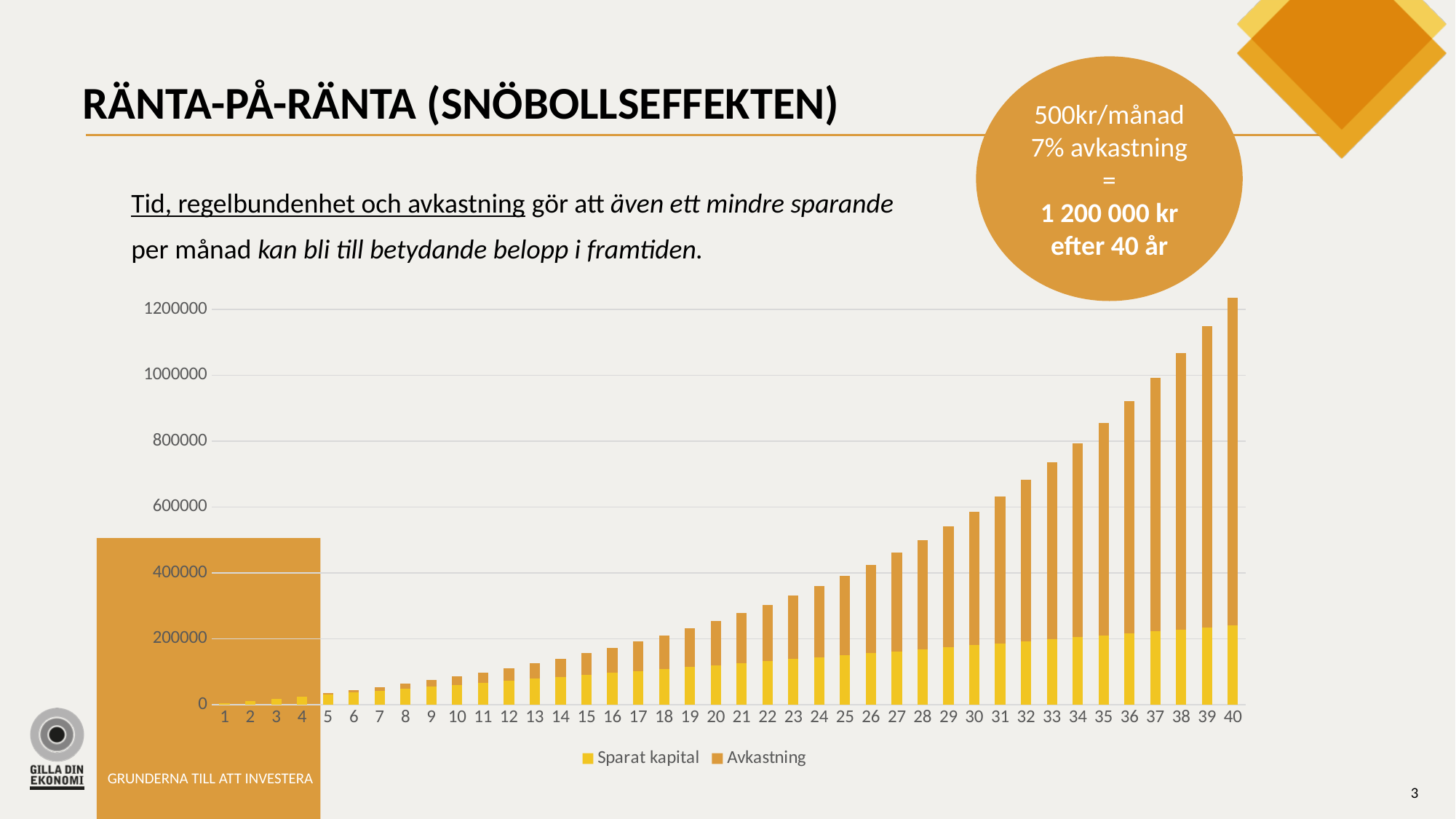
Which has the larger total bar, year 40 or year 20? Year 40 How many series does the chart legend list? 2 Is the total bar value for year 10 greater or less than 200000? less Which year has the lowest total bar in the chart? 1 What kind of chart is shown on the slide? Stacked bar chart Is the total bar value for year 35 greater or less than 800000? greater Which year has the highest total bar in the chart? 40 Is the total bar value for year 20 greater or less than 200000? greater Do the total bar values rise or fall as the years increase along the x axis? Rise Which series is shown in the darker orange colour in the chart? Avkastning How many categories (years) are shown along the x axis of the chart? 40 What are the two series named in the chart legend? Sparat kapital and Avkastning